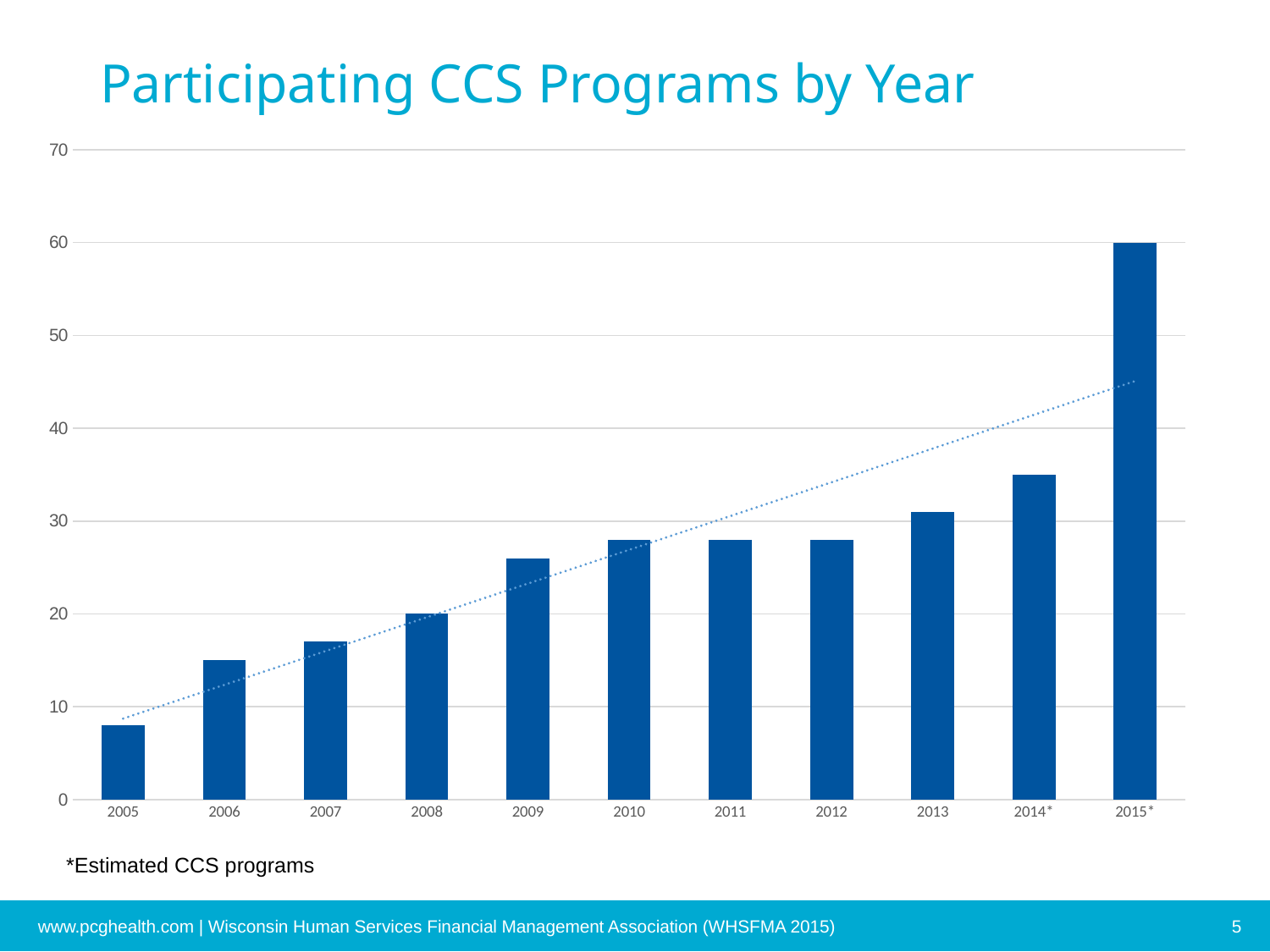
Which year has the lowest number of participating CCS programs? 2005 Which is larger, the value for 2013 or the value for 2014*? 2014* Do the values generally rise or fall from 2005 to 2015*? rise What is the value for 2015*? 60 What kind of chart is shown on the slide? bar chart How many years are shown on the x axis of the chart? 11 What is the value for 2008? 20 Is the value for 2014* greater or less than 30? greater What is the title of the chart? Participating CCS Programs by Year Is the value for 2012 greater or less than 30? less Is the value for 2005 greater or less than 10? less Which year has the highest number of participating CCS programs? 2015*